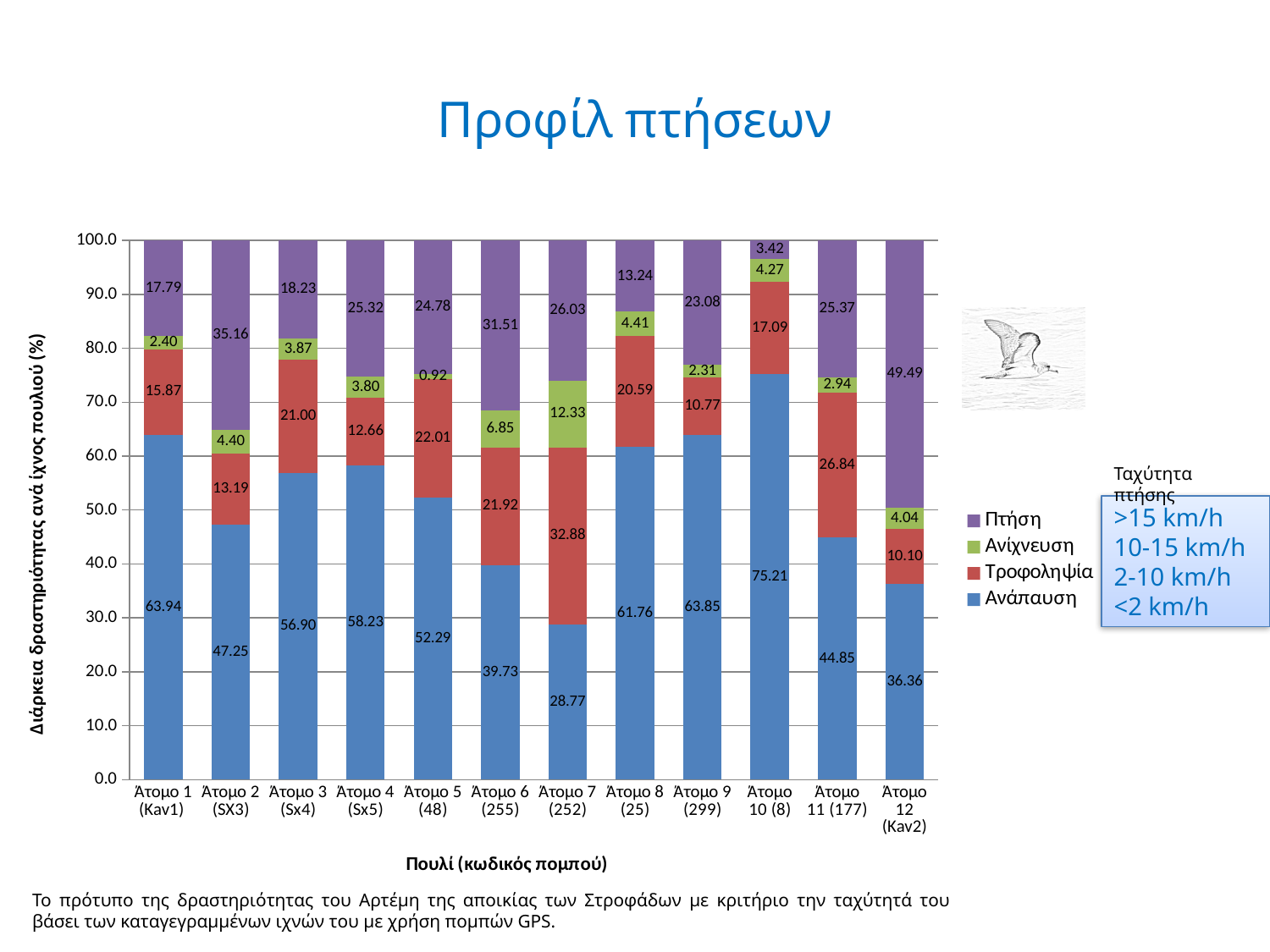
What is the difference between the Ανάπαυση values of Άτομο 1 (Kav1) and Άτομο 2 (SX3)? 16.69 Which is larger, the Τροφοληψία value for Άτομο 3 (Sx4) or for Άτομο 4 (Sx5)? Άτομο 3 (Sx4) How many birds (categories) are shown on the x axis? 12 What type of chart is shown on the slide? Stacked bar chart How many series does the legend list? 4 Which bird has the lowest Ανίχνευση value? Άτομο 5 (48) What is the Τροφοληψία value for Άτομο 11 (177)? 26.84 What is the Ανάπαυση value for Άτομο 7 (252)? 28.77 What is the Πτήση value for Άτομο 12 (Kav2)? 49.49 Which bird has the highest Ανάπαυση value? Άτομο 10 (8) Which bird has the highest Τροφοληψία value? Άτομο 7 (252) Which bird has the lowest Πτήση value? Άτομο 10 (8)